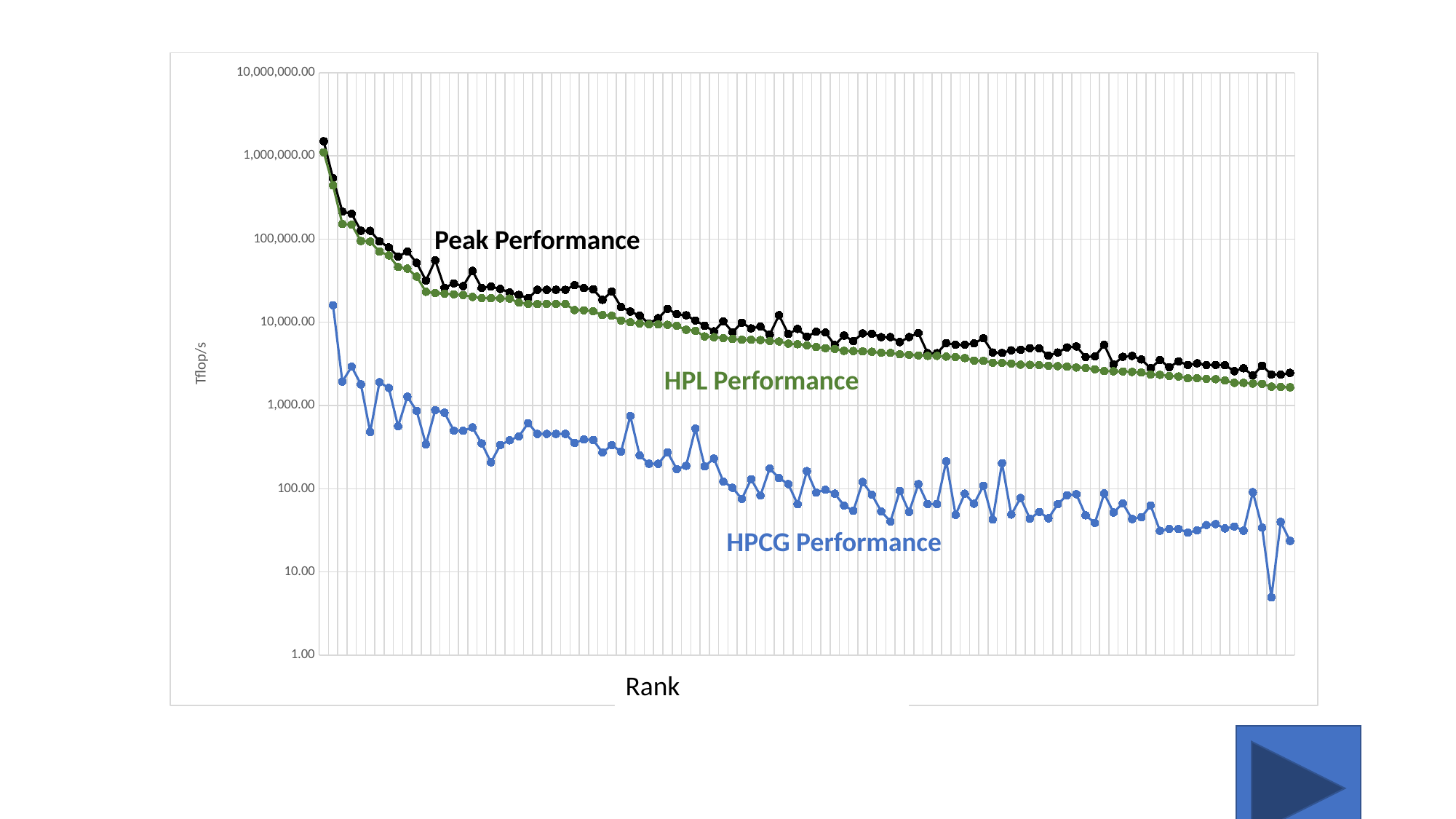
Do the Peak Performance values generally rise or fall as rank increases along the x axis? fall How many series are plotted on the chart? 3 What kind of chart is shown on the slide? line chart Is the Peak Performance value at the first rank greater or less than 1,000,000.00? greater Is the lowest HPCG Performance value on the chart greater or less than 10.00? less Is the Peak Performance value at the last rank greater or less than 10,000.00? less What is the label on the y axis of the chart? Tflop/s What colour is the HPCG Performance series drawn in? blue Which series has the lowest values across the ranks? HPCG Performance Which series has the highest values across the ranks? Peak Performance At the first rank, which is larger: Peak Performance or HPCG Performance? Peak Performance